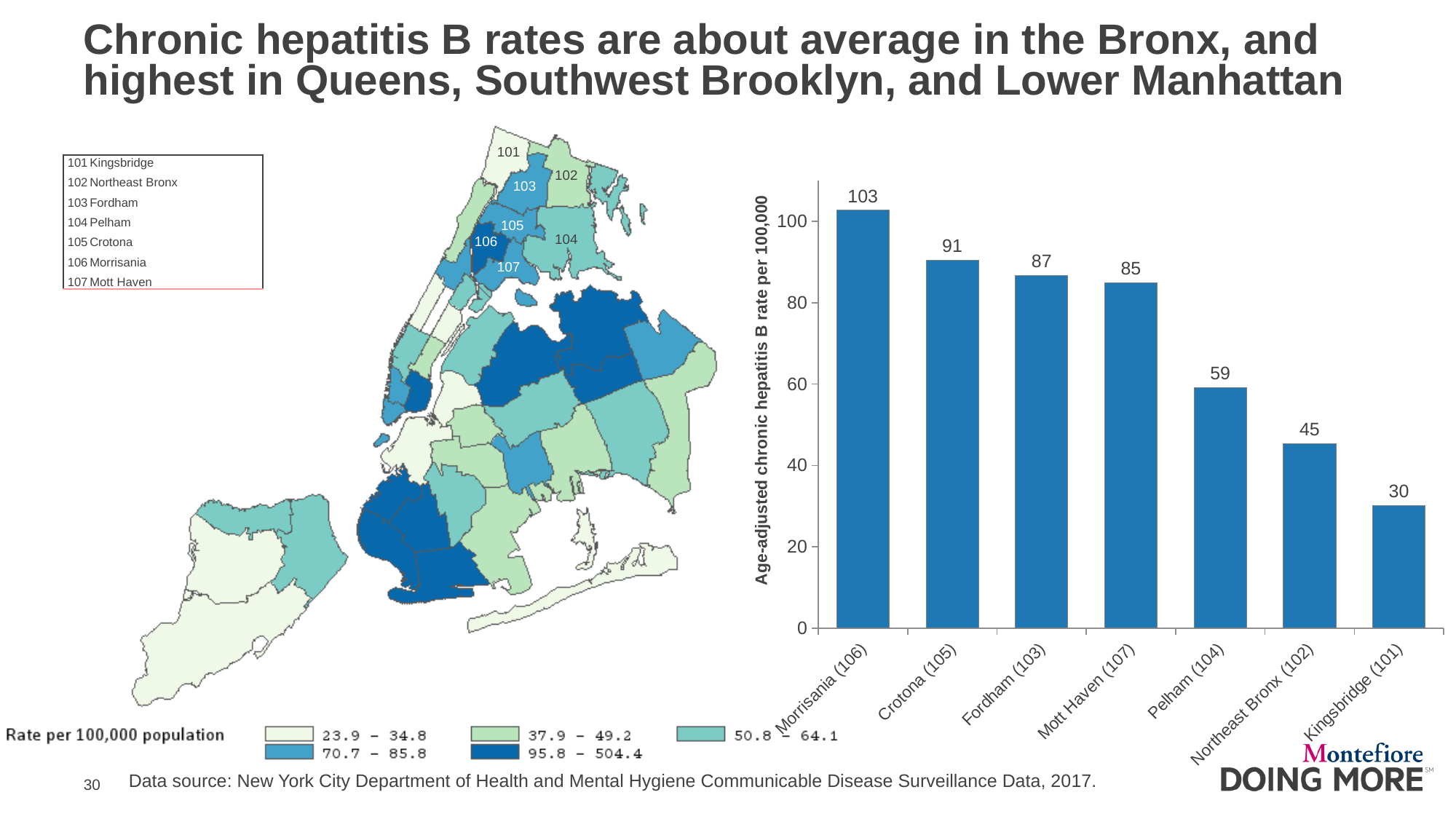
Is the chronic hepatitis B rate for Pelham (104) greater or less than 80? less What is the difference between the chronic hepatitis B rates of Crotona (105) and Northeast Bronx (102)? 46 Which has a higher chronic hepatitis B rate, Fordham (103) or Mott Haven (107)? Fordham (103) What is the label of the vertical axis of the bar chart? Age-adjusted chronic hepatitis B rate per 100,000 Which neighborhood has the highest chronic hepatitis B rate in the bar chart? Morrisania (106) What type of chart is used to show the chronic hepatitis B rates by neighborhood? bar chart What is the age-adjusted chronic hepatitis B rate per 100,000 for Kingsbridge (101)? 30 Do the bar values rise or fall from left to right across the bar chart? fall Which neighborhood has the lowest chronic hepatitis B rate in the bar chart? Kingsbridge (101) What is the age-adjusted chronic hepatitis B rate per 100,000 for Morrisania (106)? 103 How many neighborhoods are shown in the bar chart? 7 What is the age-adjusted chronic hepatitis B rate per 100,000 for Pelham (104)? 59